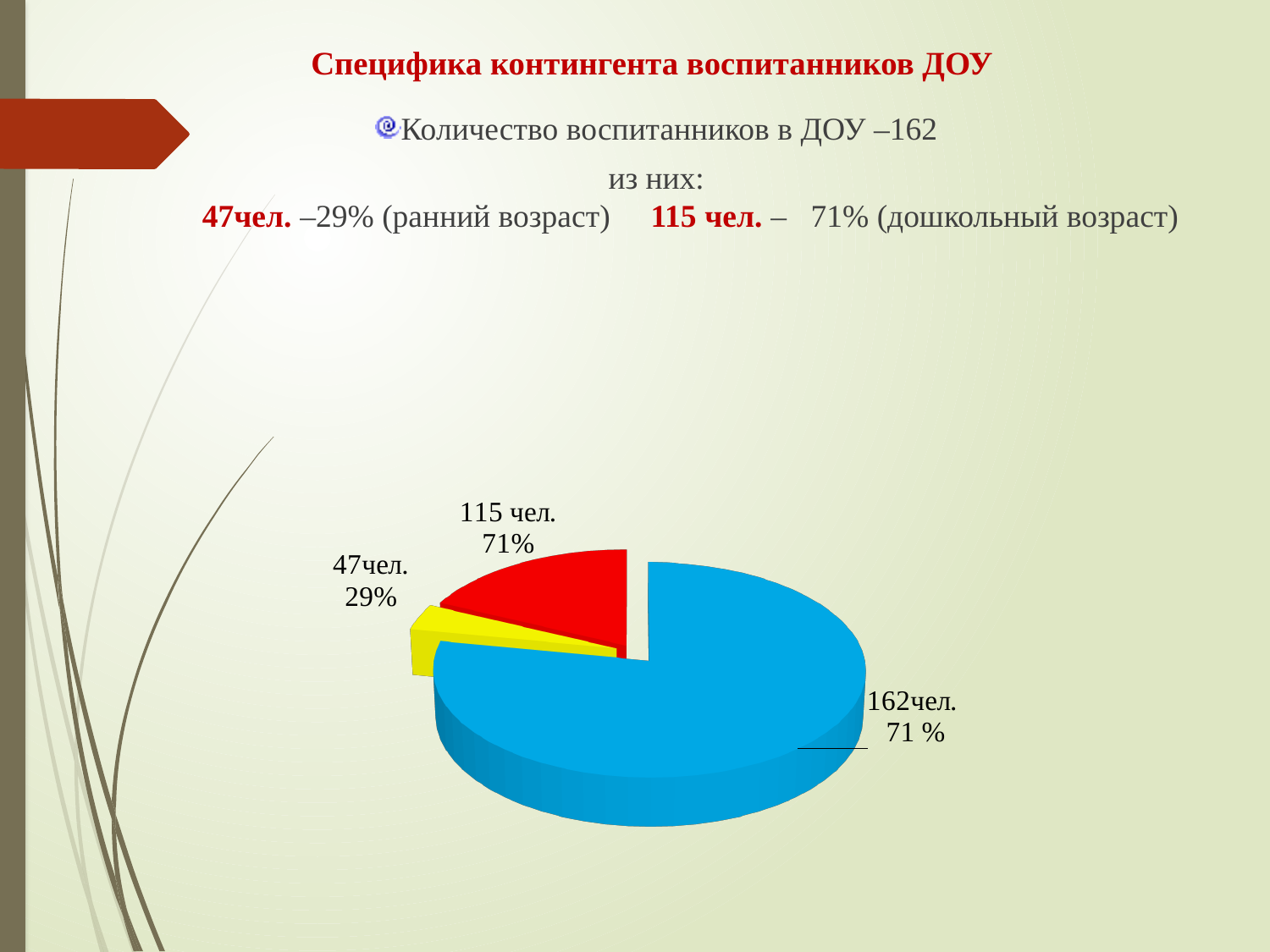
What label is printed next to the blue slice of the pie chart? 162чел. 71 % What kind of chart is shown on the slide? pie chart How many slices does the pie chart have? 3 What percentage is printed for the yellow slice of the pie chart? 29% Which slice of the pie chart is the smallest? the yellow slice (47чел.) What percentage is printed for the red slice of the pie chart? 71% What share of the pie is printed for the slice labelled 47чел.? 29% How many people (чел.) are printed for the red slice of the pie chart? 115 чел. What colour is the largest slice of the pie chart? blue Which slice is larger, the red slice or the yellow slice? the red slice What is the difference between the number of people printed for the red slice and the yellow slice? 68 чел. Which slice of the pie chart is the largest? the blue slice (162чел.)